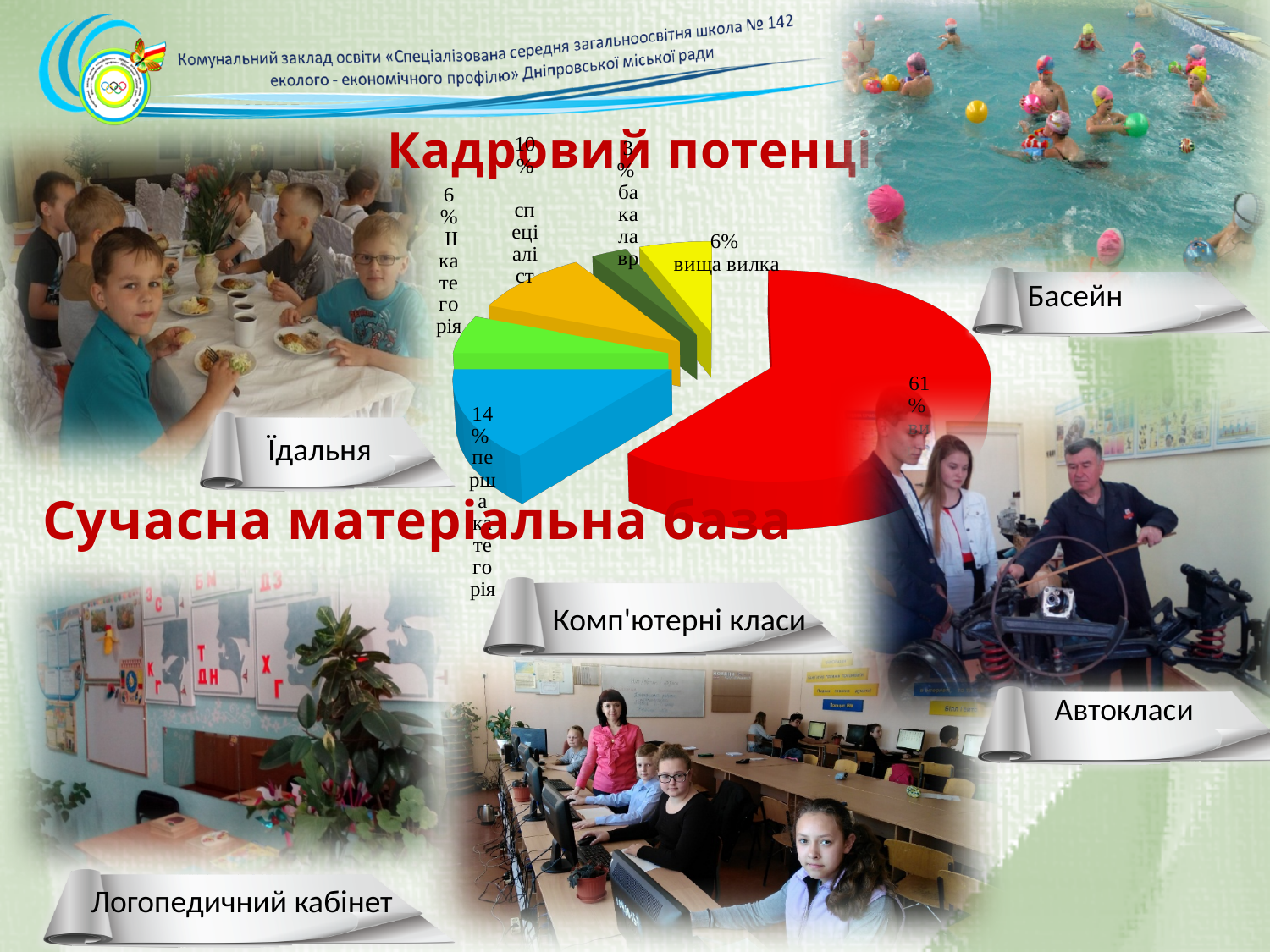
Which is larger, the slice for перша категорія or the slice for спеціаліст? перша категорія What percentage is shown for спеціаліст? 10% What is the difference in percentage points between спеціаліст and бакалавр? 7 What kind of chart is shown on the slide? pie chart How many slices does the pie chart have? 6 What colour is the largest slice of the pie chart? red What percentage is shown for перша категорія? 14% What is the value of the largest slice in the pie chart? 61% Which category has the smallest slice in the pie chart? бакалавр What percentage is shown for вища вилка? 6% What percentage is shown for ІІ категорія? 6% What percentage is shown for бакалавр? 3%